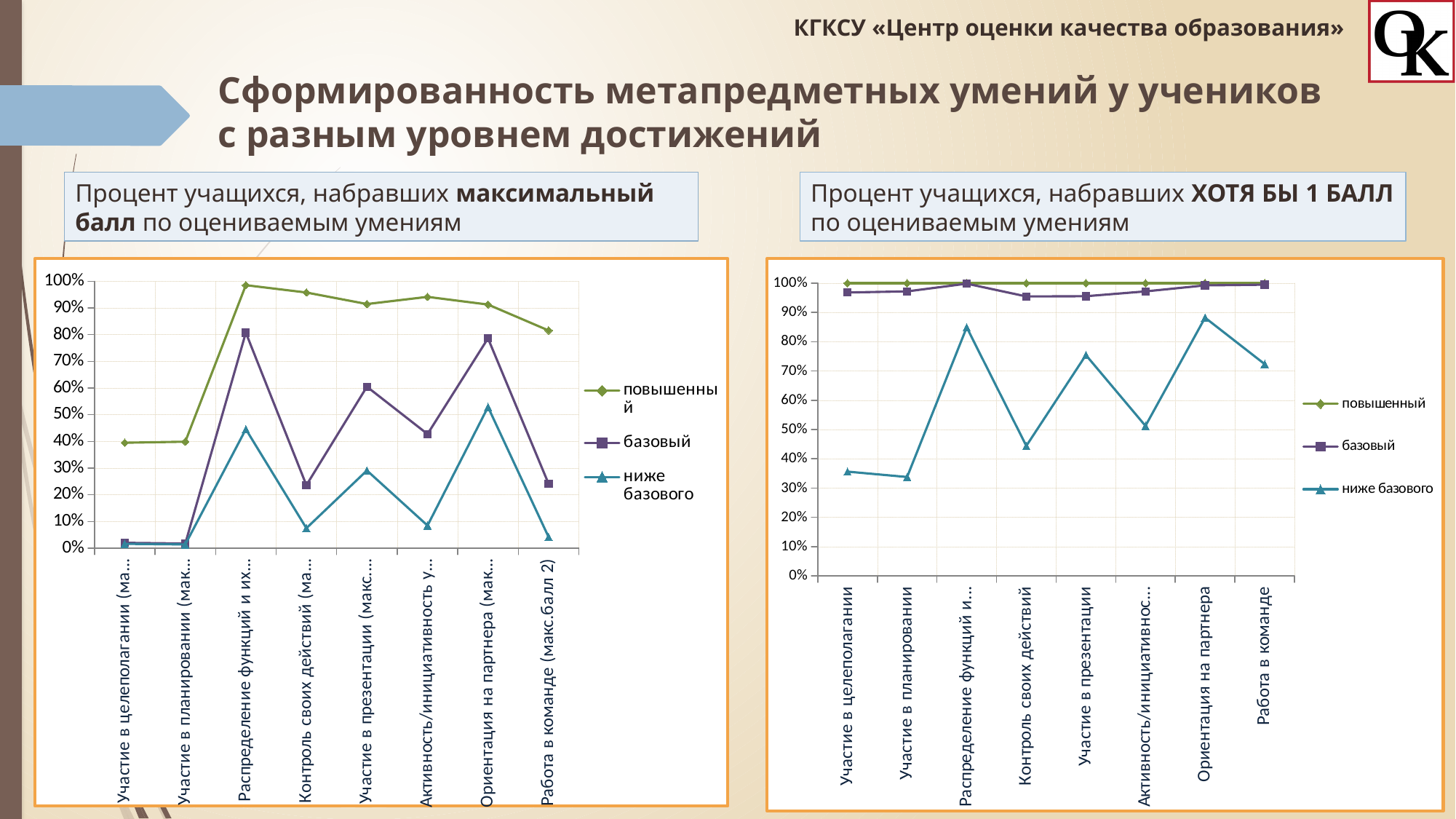
In the left chart (percent scoring the maximum), is the value of базовый for Распределение функций greater or less than 70%? greater What kind of chart is the left chart (percent of students scoring the maximum)? line chart How many categories are shown on the x axis of the right chart (percent scoring at least 1 point)? 8 In the left chart (percent scoring the maximum), which series has the highest value for Участие в презентации? повышенный In the right chart (percent scoring at least 1 point), which is larger for the ниже базового series: Участие в презентации or Активность/инициативность? Участие в презентации How many series does the legend of the right chart (percent scoring at least 1 point) list? 3 In the left chart (percent scoring the maximum), is the value of повышенный for Участие в целеполагании greater or less than 50%? less In the right chart (percent scoring at least 1 point), does the ниже базового series rise or fall from Ориентация на партнера to Работа в команде? fall In the right chart (percent scoring at least 1 point), is the value of ниже базового for Распределение функций greater or less than 80%? greater In the right chart (percent scoring at least 1 point), what is the value of the повышенный series for Работа в команде? 100% In the left chart (percent scoring the maximum), for which category does the ниже базового series reach its highest value? Ориентация на партнера